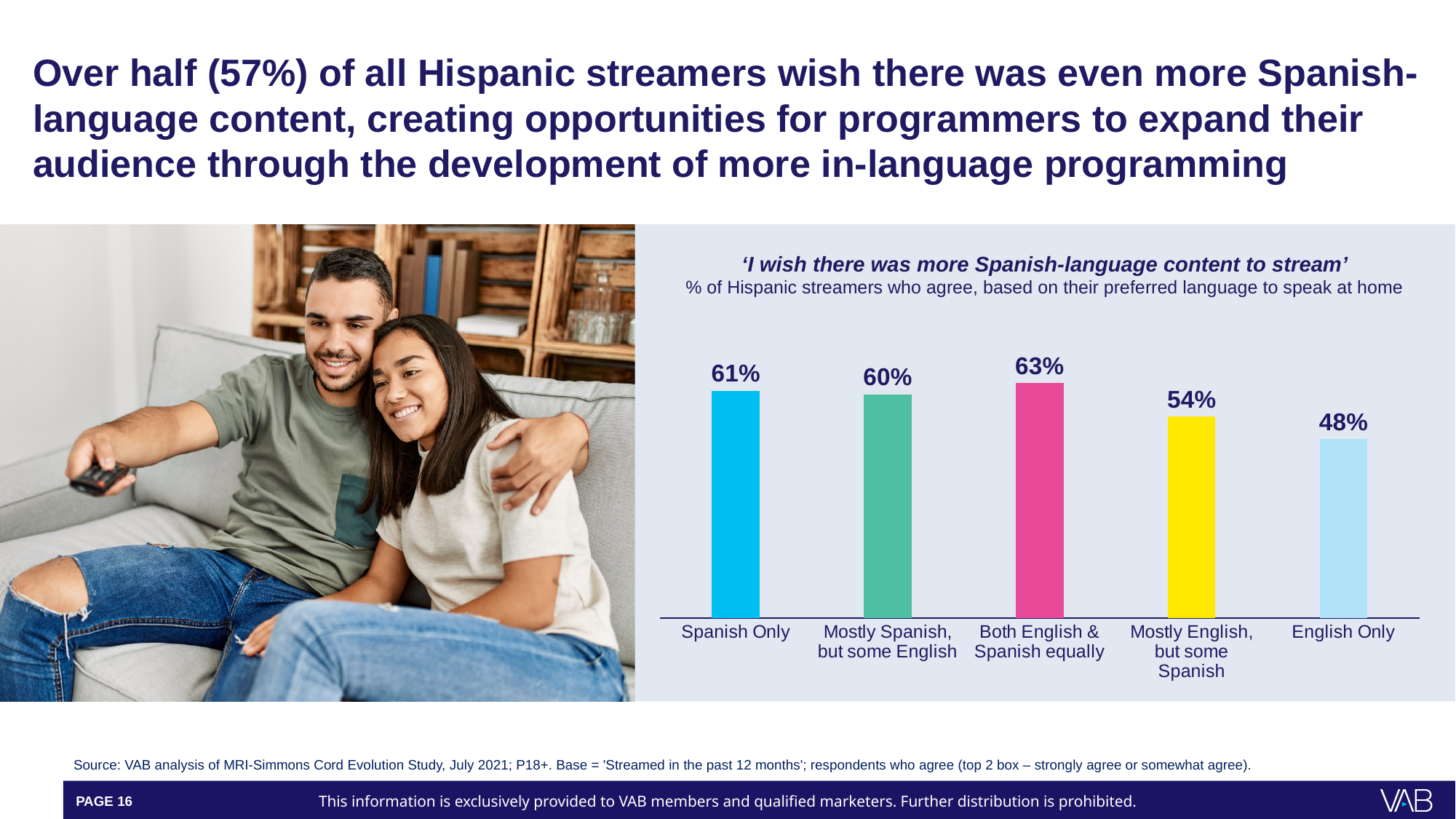
How many language categories are shown in the chart? 5 What is the difference in percentage points between 'Both English & Spanish equally' and 'English Only'? 15 What percentage of Hispanic streamers who speak Spanish Only at home agree they wish there was more Spanish-language content to stream? 61% What type of chart is used on this slide? Bar chart Do the values generally rise or fall moving from 'Both English & Spanish equally' to 'English Only'? Fall What is the difference in percentage points between 'Spanish Only' and 'Mostly Spanish, but some English'? 1 What is the value shown for the 'English Only' category? 48% Which is larger: the value for 'Mostly Spanish, but some English' or the value for 'Mostly English, but some Spanish'? Mostly Spanish, but some English What is the value shown for 'Mostly English, but some Spanish'? 54% What is the title of the chart? 'I wish there was more Spanish-language content to stream' Which language group has the lowest share agreeing? English Only Which language group has the highest share agreeing they wish there was more Spanish-language content? Both English & Spanish equally